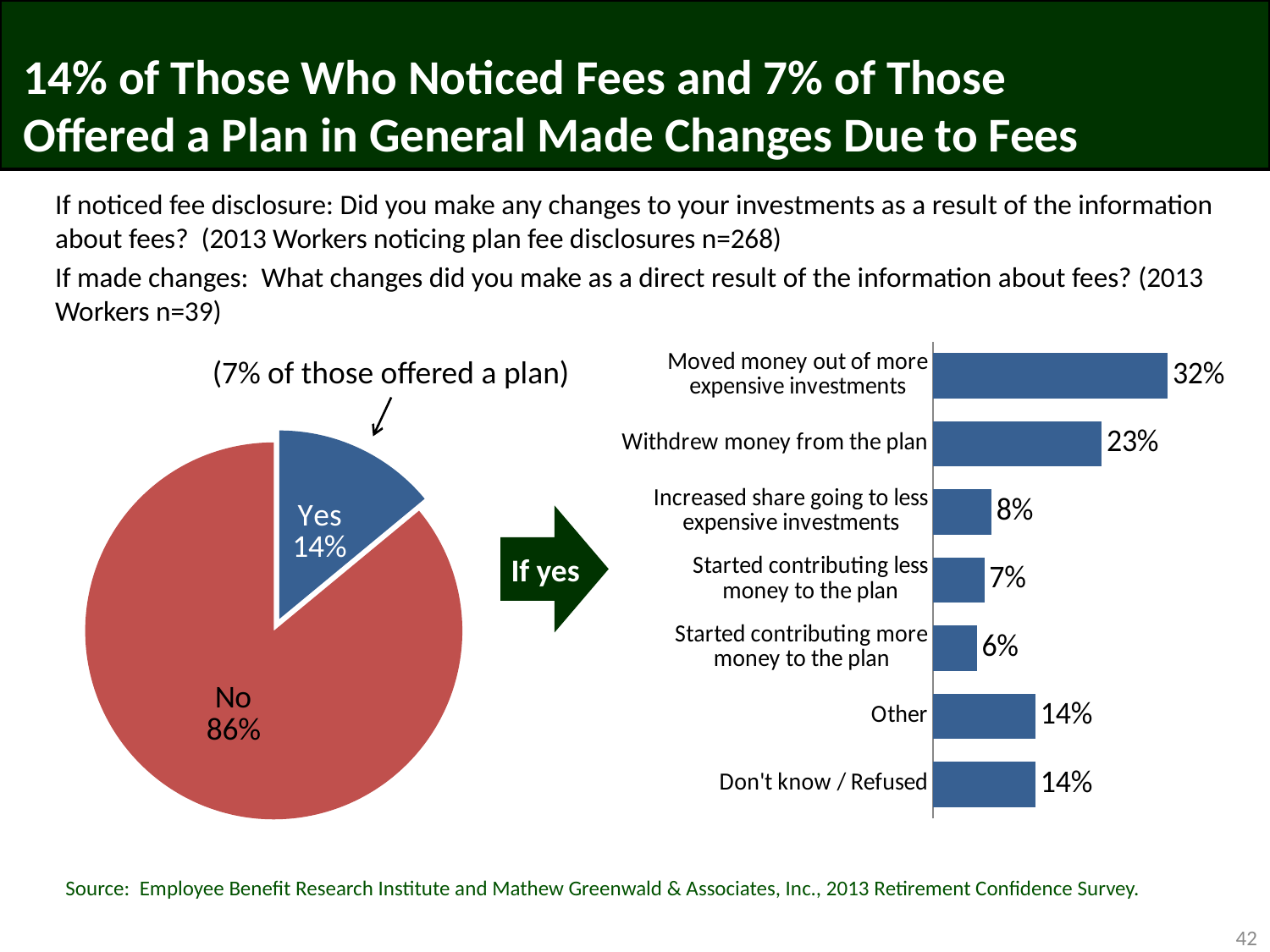
In the pie chart on the left, what share of respondents answered No? 86% What kind of chart is the chart on the right of the slide? Bar chart In the bar chart on the right, which category has the highest value? Moved money out of more expensive investments In the bar chart on the right, which category has the lowest value? Started contributing more money to the plan In the pie chart on the left, which slice is larger, Yes or No? No In the bar chart on the right, what is the difference between 'Moved money out of more expensive investments' and 'Withdrew money from the plan'? 9% In the bar chart on the right, what is the value for 'Withdrew money from the plan'? 23% What kind of chart is the chart on the left of the slide? Pie chart How many categories are shown in the bar chart on the right? 7 In the bar chart on the right, what is the value for 'Started contributing more money to the plan'? 6% In the pie chart on the left, what share of respondents answered Yes? 14% In the bar chart on the right, which is larger: 'Increased share going to less expensive investments' or 'Other'? Other